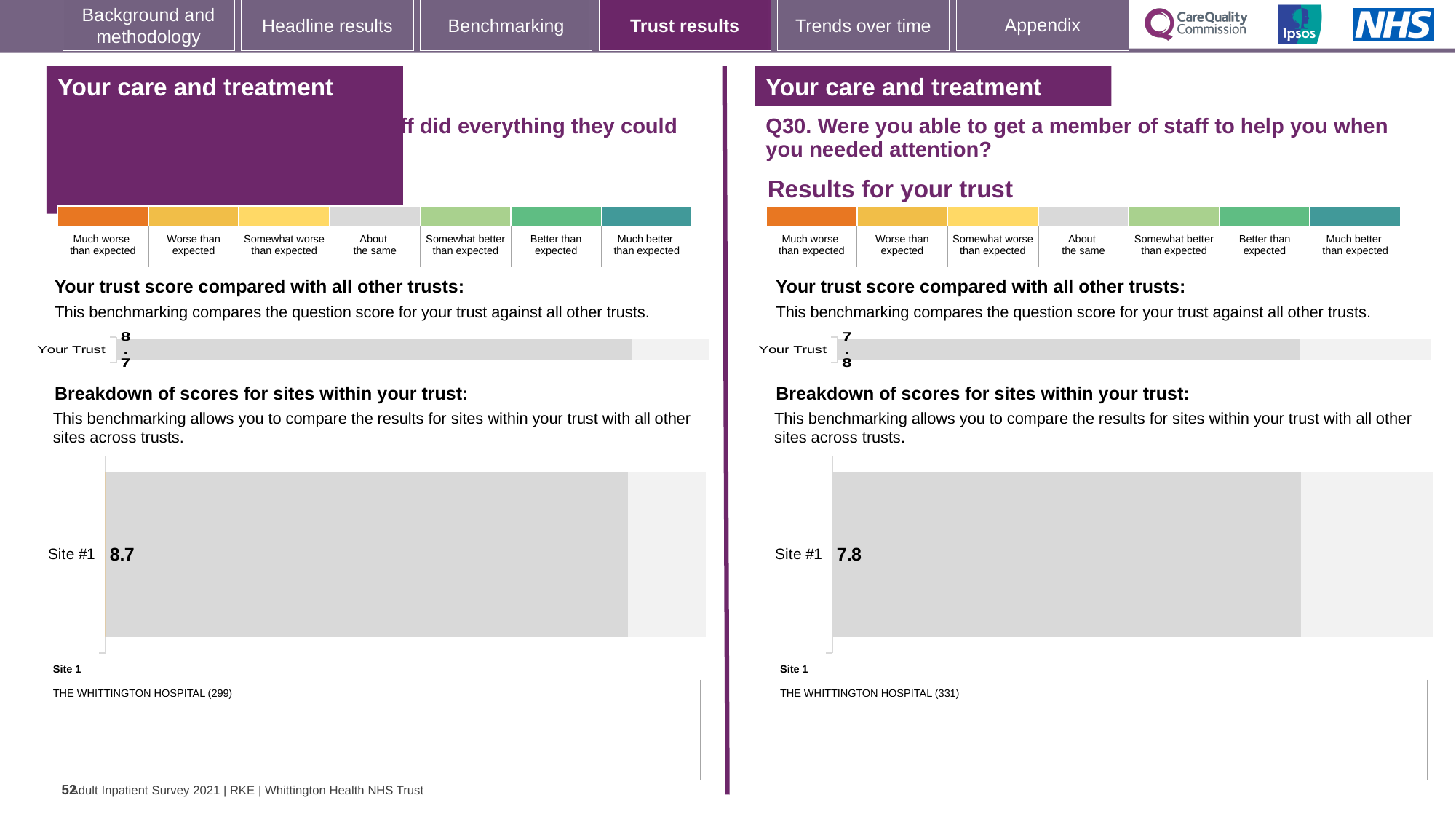
On the left panel, what is the value shown for Your Trust in the chart comparing your trust score with all other trusts? 8.7 How many sites are shown in the breakdown of scores chart on the left panel? 1 How many sites are shown in the breakdown of scores chart on the right panel (Q30)? 1 Which Site #1 score is larger: the one on the left panel or the one on the right panel (Q30)? Left panel (8.7) On the right panel, which site is listed as Site 1 below the breakdown chart? THE WHITTINGTON HOSPITAL (331) On the right panel (Q30), what is the value shown for Your Trust in the chart comparing your trust score with all other trusts? 7.8 On the left panel, what is the score shown for Site #1 in the breakdown of scores for sites within your trust? 8.7 On the right panel (Q30), what is the score shown for Site #1 in the breakdown of scores for sites within your trust? 7.8 On the right panel (Q30), is the Your Trust score the same as the Site #1 score? Yes, both are 7.8 On the left panel, which site is listed as Site 1 below the breakdown chart? THE WHITTINGTON HOSPITAL (299) What kind of chart is used to show the Site #1 score on the right panel (Q30)? Bar chart What is the difference between the Site #1 score on the left panel and the Site #1 score on the right panel (Q30)? 0.9